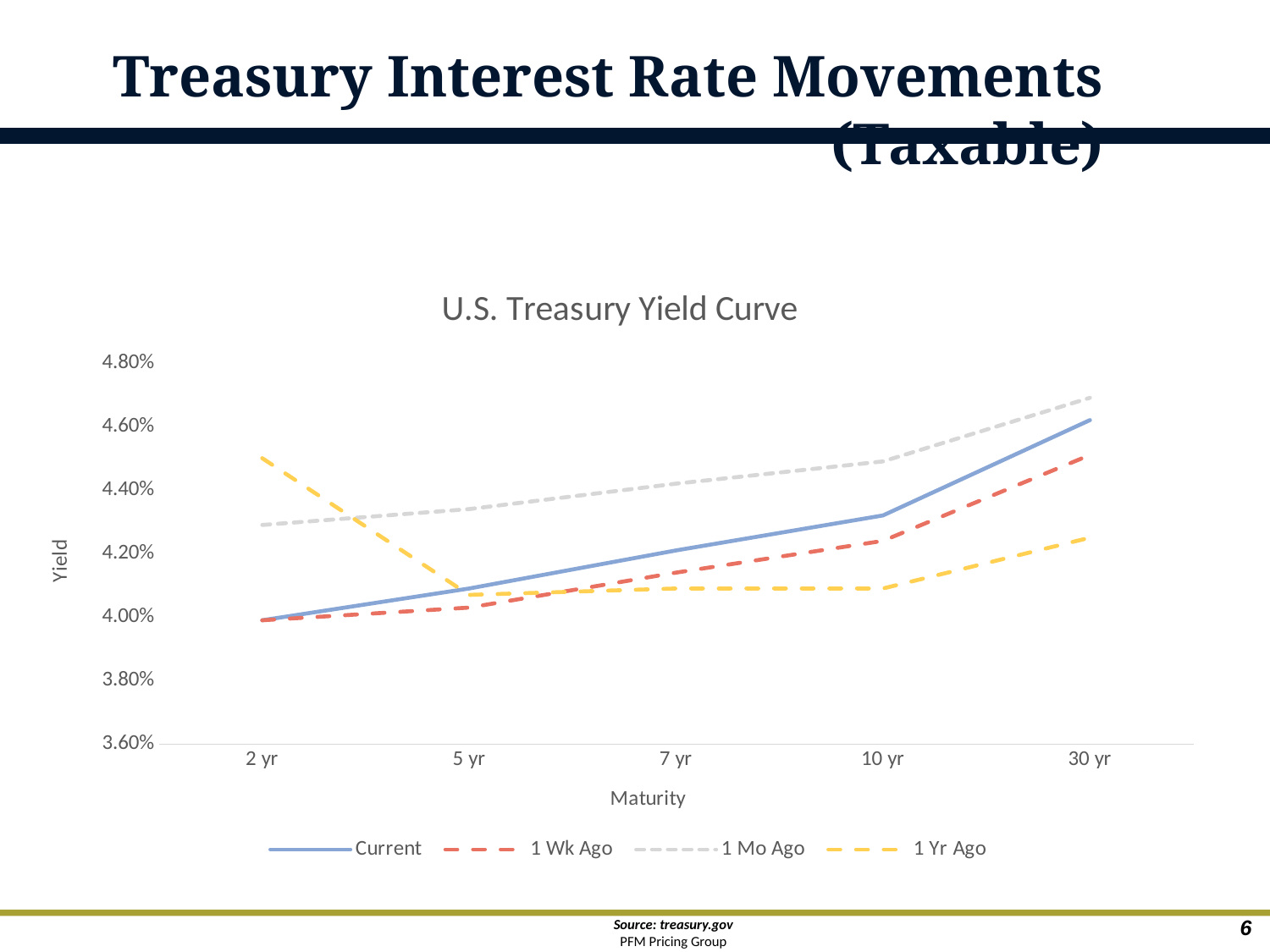
Is the 1 Yr Ago yield at 2 yr greater or less than 4.40%? greater Which series has the lowest yield at the 30 yr maturity? 1 Yr Ago Is the Current yield at 30 yr greater or less than 4.40%? greater What kind of chart is the U.S. Treasury Yield Curve chart? line chart How many series does the legend of the U.S. Treasury Yield Curve chart list? 4 At the 2 yr maturity, which is higher: the Current yield or the 1 Yr Ago yield? 1 Yr Ago Which series has the highest yield at the 30 yr maturity? 1 Mo Ago Is the 1 Wk Ago yield at 2 yr greater or less than 4.20%? less How many maturities are shown on the x axis of the U.S. Treasury Yield Curve chart? 5 What is the title of the chart on the slide? U.S. Treasury Yield Curve Does the Current yield rise or fall as maturity increases from 2 yr to 30 yr? rises